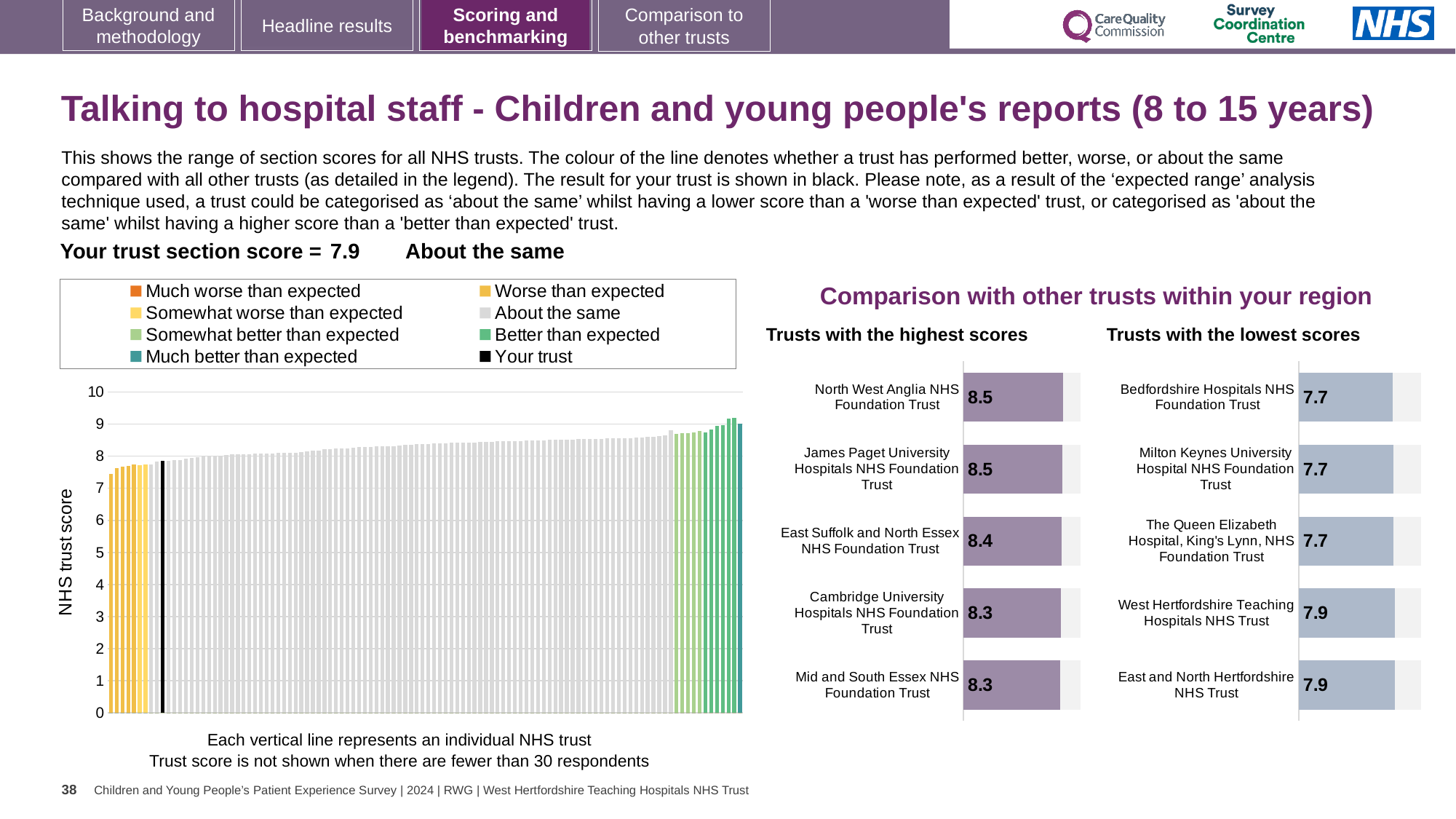
In the 'Trusts with the lowest scores' chart, what is the difference between the scores of West Hertfordshire Teaching Hospitals NHS Trust and Bedfordshire Hospitals NHS Foundation Trust? 0.2 In the 'Trusts with the lowest scores' chart, what is the score for West Hertfordshire Teaching Hospitals NHS Trust? 7.9 In the 'Trusts with the highest scores' chart, how many trusts are shown? 5 In the 'Trusts with the highest scores' chart, what is the score for East Suffolk and North Essex NHS Foundation Trust? 8.4 In the large chart on the left, is the value of the black bar (your trust) greater or less than 7? greater What kind of chart is the large chart on the left showing NHS trust scores? bar chart In the large chart on the left, what is the label on the vertical axis? NHS trust score In the 'Trusts with the highest scores' chart, what is the difference between the scores of North West Anglia NHS Foundation Trust and Cambridge University Hospitals NHS Foundation Trust? 0.2 In the 'Trusts with the lowest scores' chart, which trust has the highest score: Bedfordshire Hospitals NHS Foundation Trust or East and North Hertfordshire NHS Trust? East and North Hertfordshire NHS Trust In the 'Trusts with the lowest scores' chart, what is the score for The Queen Elizabeth Hospital, King's Lynn, NHS Foundation Trust? 7.7 How many entries does the legend above the large chart on the left list? 8 In the large chart on the left, do the trust scores rise or fall from left to right along the x axis? rise